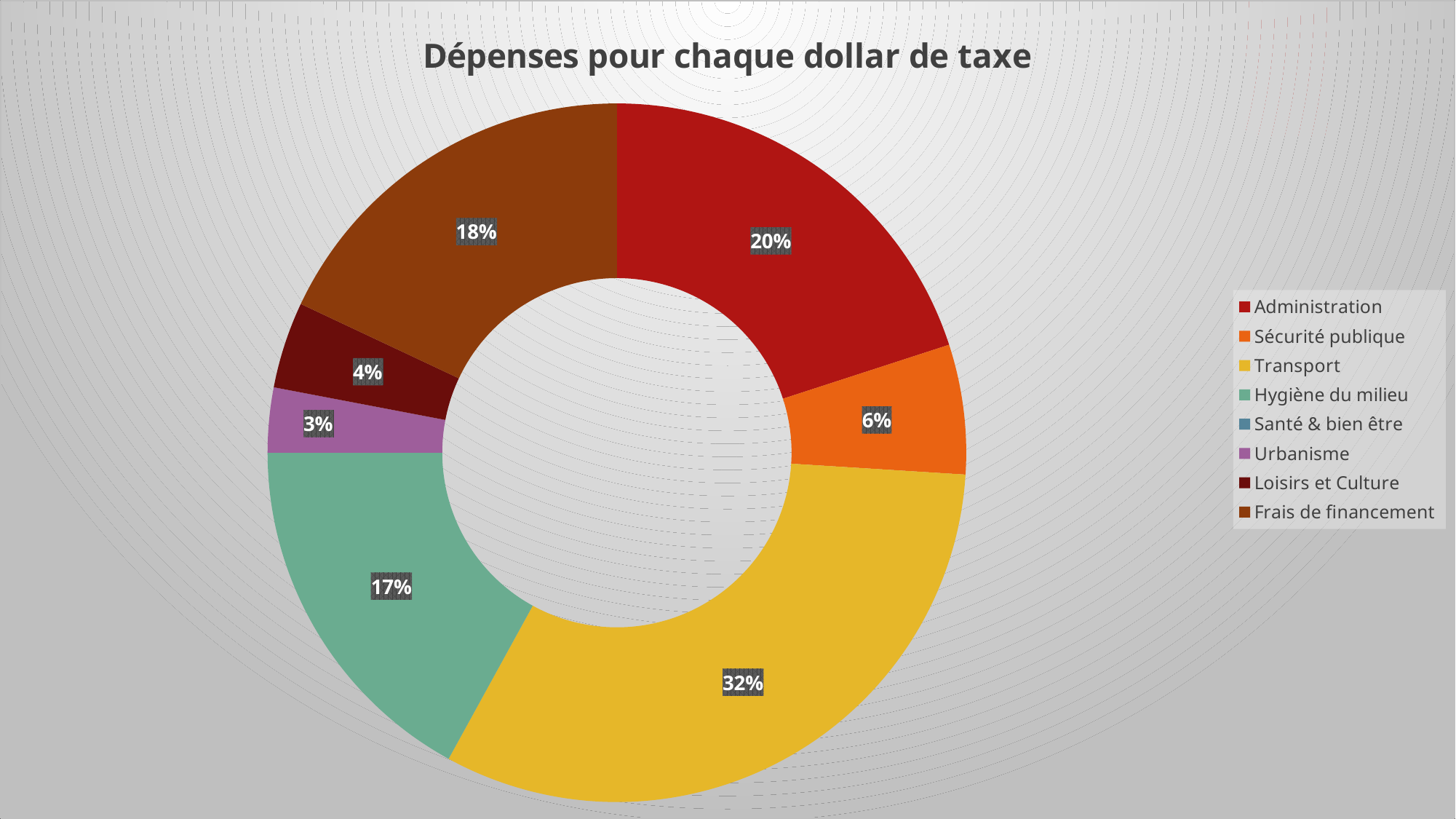
What is the value shown for Administration? 20% How many categories does the legend list? 8 What is the title of the chart? Dépenses pour chaque dollar de taxe What kind of chart is shown on the slide? doughnut chart Which labelled category has the smallest share of the chart? Urbanisme What is the difference between the Transport share and the Administration share? 12% Which is larger, the share for Frais de financement or the share for Hygiène du milieu? Frais de financement What percentage is shown for Hygiène du milieu? 17% What percentage is shown for Urbanisme? 3% What is the value for Frais de financement? 18% What percentage of each tax dollar goes to Transport? 32% Which category has the largest share of the chart? Transport